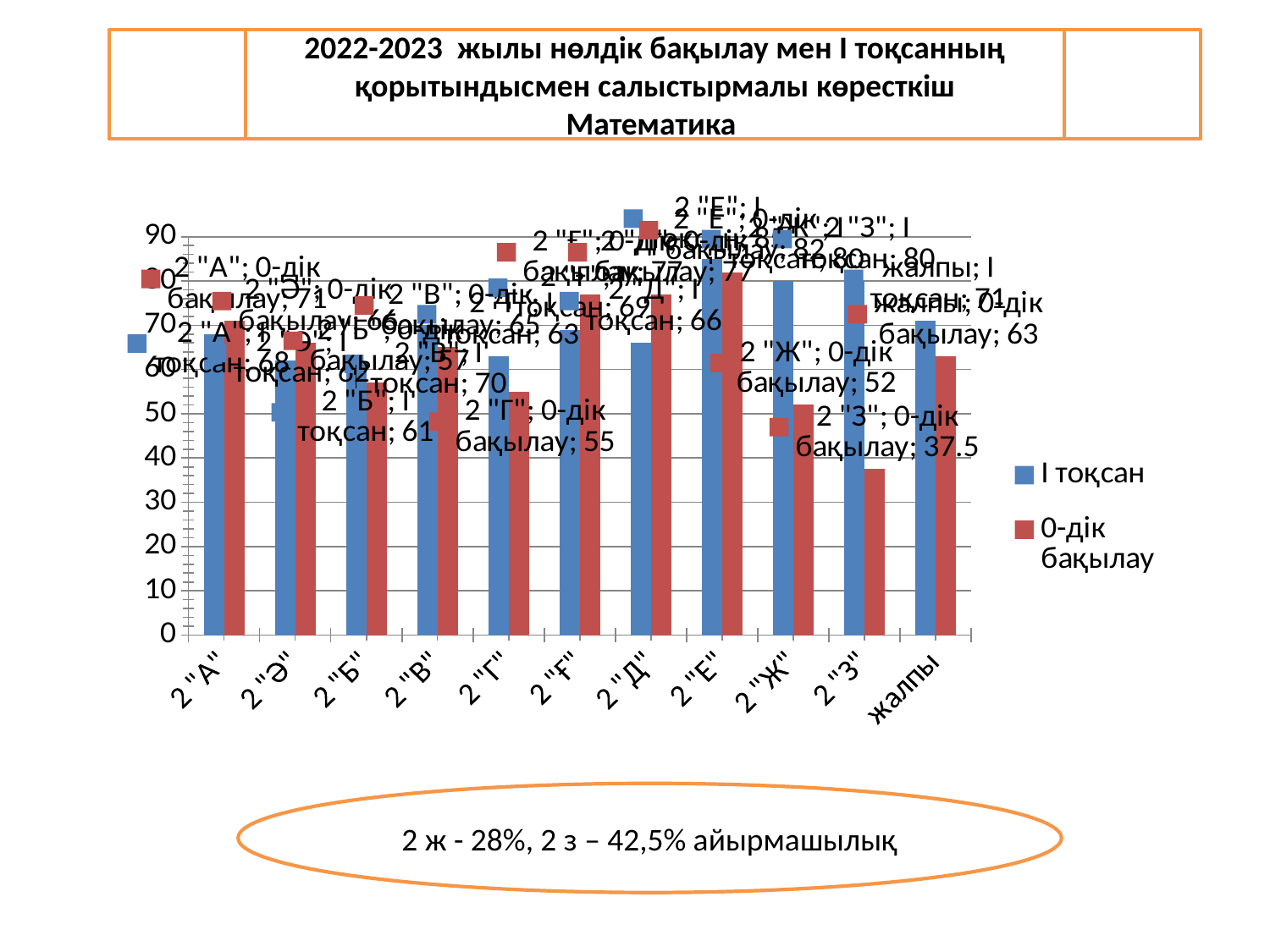
For 2 "Ж", which is larger: the I тоқсан value or the 0-дік бақылау value? I тоқсан Which category has the lowest 0-дік бақылау value? 2 "З" What is the difference between the I тоқсан and 0-дік бақылау values for жалпы? 8 What is the I тоқсан value for жалпы? 71 What is the 0-дік бақылау value for 2 "Ж"? 52 Which category has the highest I тоқсан value? 2 "Е" What kind of chart is shown on the slide? bar chart How many categories are shown along the x axis of the chart? 11 What is the 0-дік бақылау value for жалпы? 63 What is the 0-дік бақылау value for 2 "Г"? 55 How many series does the chart legend list? 2 What is the 0-дік бақылау value for 2 "З"? 37.5